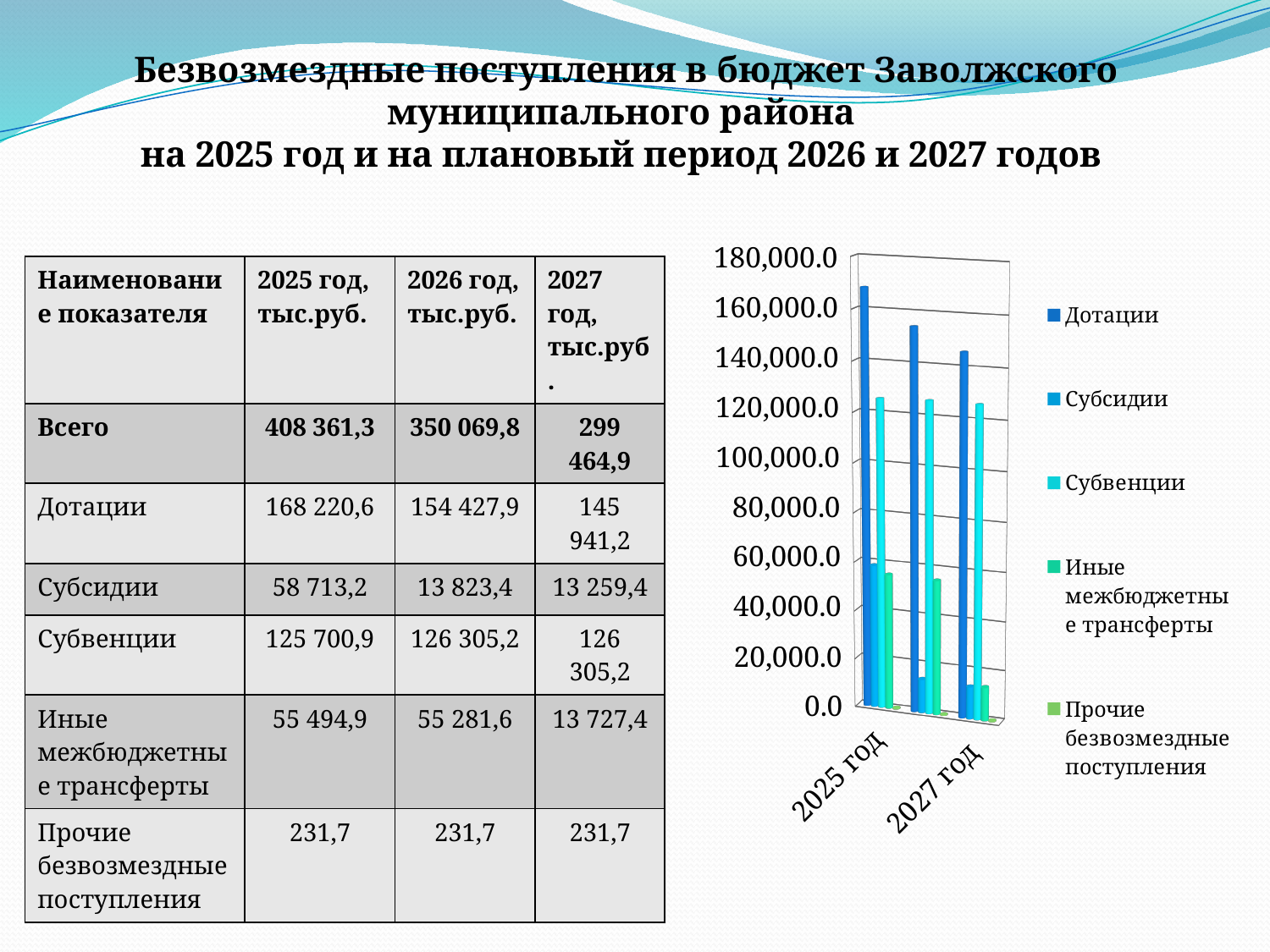
Which entry appears first in the chart legend? Дотации How many groups of bars are plotted in the chart? 3 What kind of chart is shown on the right of the slide? bar chart Which series has the tallest bar for 2025 год in the chart? Дотации How many series does the chart legend list? 5 According to the table on the slide, what is the value of Дотации for 2025 год, тыс.руб.? 168 220,6 In the chart, which is larger for 2027 год: Субвенции or Субсидии? Субвенции Do the bars for Дотации rise or fall from 2025 год to 2027 год? fall In the chart, is the value for Субсидии in 2027 год greater or less than 20,000.0? less According to the table on the slide, what is the value of Субвенции for 2026 год, тыс.руб.? 126 305,2 Which series has the shortest bar for 2025 год in the chart? Прочие безвозмездные поступления In the chart, is the value for Дотации in 2025 год greater or less than 140,000.0? greater